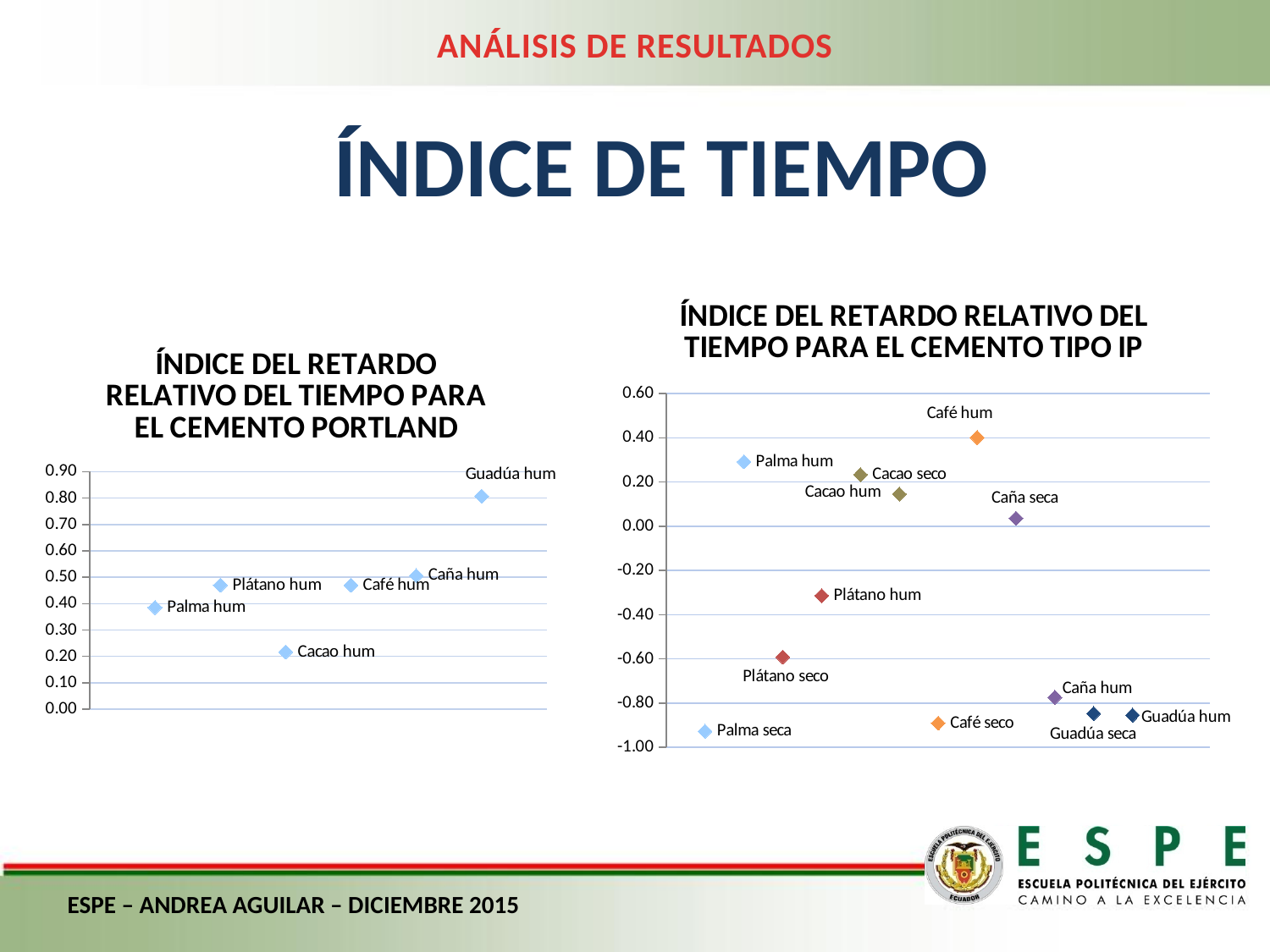
In the chart for 'EL CEMENTO PORTLAND' (left), which is larger, the value for Guadúa hum or the value for Palma hum? Guadúa hum In the chart for 'EL CEMENTO PORTLAND' (left), is the value for Cacao hum greater or less than 0.30? less In the chart for 'EL CEMENTO PORTLAND' (left), which point has the highest value? Guadúa hum In the chart for 'EL CEMENTO TIPO IP' (right), is the value for Plátano seco greater or less than -0.40? less What is the title of the chart on the right side of the slide? ÍNDICE DEL RETARDO RELATIVO DEL TIEMPO PARA EL CEMENTO TIPO IP In the chart for 'EL CEMENTO TIPO IP' (right), which is larger, the value for Palma hum or the value for Plátano hum? Palma hum What kind of chart is the chart titled 'ÍNDICE DEL RETARDO RELATIVO DEL TIEMPO PARA EL CEMENTO PORTLAND'? Scatter chart In the chart for 'EL CEMENTO TIPO IP' (right), which point has the highest value? Café hum In the chart for 'EL CEMENTO PORTLAND' (left), how many data points are plotted? 6 In the chart for 'EL CEMENTO PORTLAND' (left), is the value for Guadúa hum greater or less than 0.70? greater In the chart for 'EL CEMENTO PORTLAND' (left), which point has the lowest value? Cacao hum In the chart for 'EL CEMENTO TIPO IP' (right), how many data points are plotted? 12